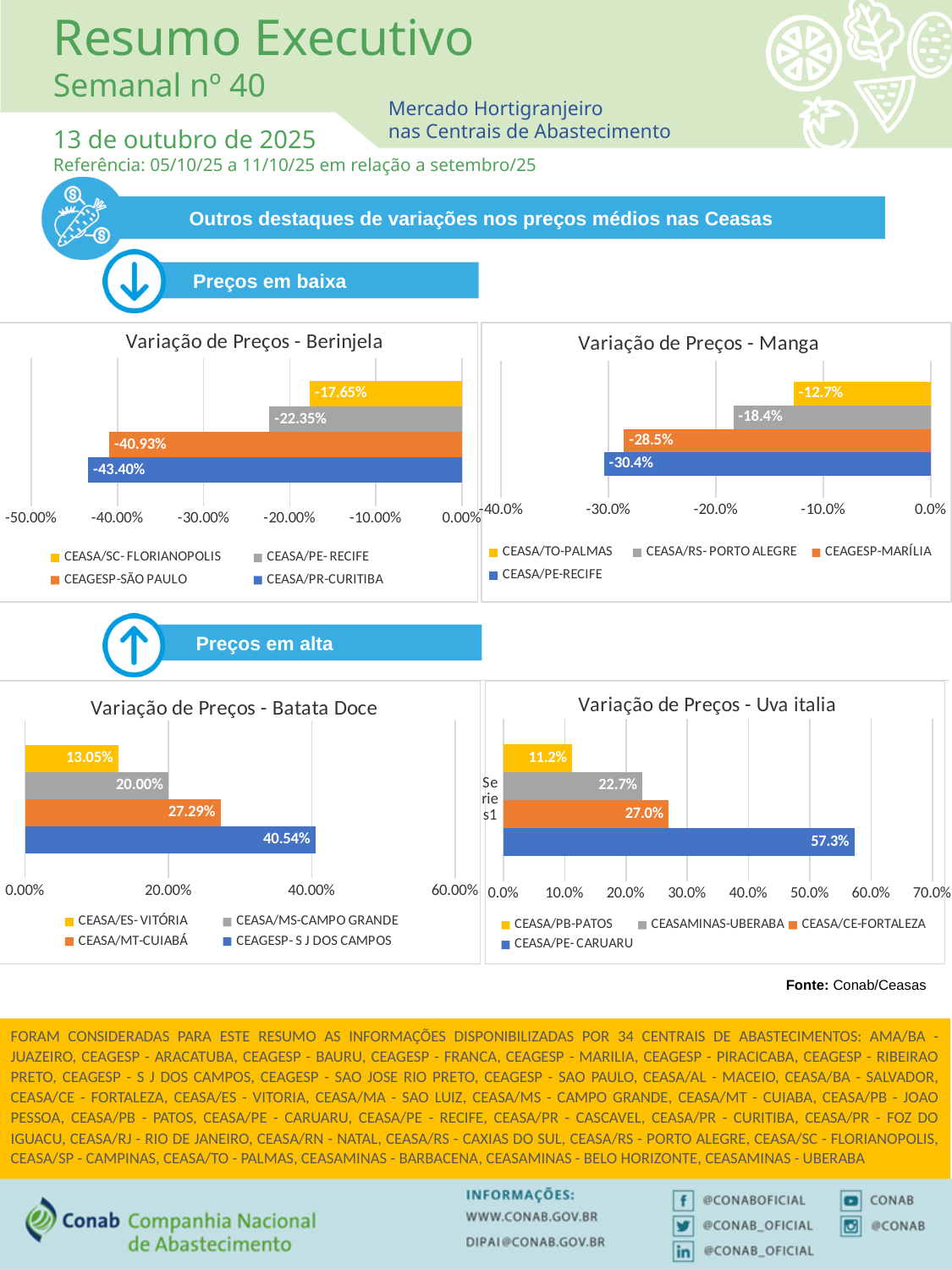
In the 'Variação de Preços - Manga' chart, which market shows the smallest price decrease? CEASA/TO-PALMAS In the 'Variação de Preços - Batata Doce' chart, which market has the highest price increase? CEAGESP-S J DOS CAMPOS In the 'Variação de Preços - Batata Doce' chart, which is larger: the value for CEASA/MT-CUIABÁ or CEASA/MS-CAMPO GRANDE? CEASA/MT-CUIABÁ In the 'Variação de Preços - Manga' chart, what is the value for CEAGESP-MARÍLIA? -28.5% How many series does the legend of the 'Variação de Preços - Manga' chart list? 4 In the 'Variação de Preços - Berinjela' chart, what is the value for CEASA/PE-RECIFE? -22.35% What kind of chart is 'Variação de Preços - Uva italia'? Bar chart In the 'Variação de Preços - Berinjela' chart, what is the value for CEASA/PR-CURITIBA? -43.40% In the 'Variação de Preços - Berinjela' chart, what is the difference between the values for CEAGESP-SÃO PAULO and CEASA/SC-FLORIANOPOLIS? 23.28 percentage points In the 'Variação de Preços - Batata Doce' chart, what is the value for CEAGESP-S J DOS CAMPOS? 40.54% In the 'Variação de Preços - Uva italia' chart, what is the value for CEASA/PE-CARUARU? 57.3% In the 'Variação de Preços - Uva italia' chart, what is the difference between the values for CEASA/CE-FORTALEZA and CEASA/PB-PATOS? 15.8 percentage points